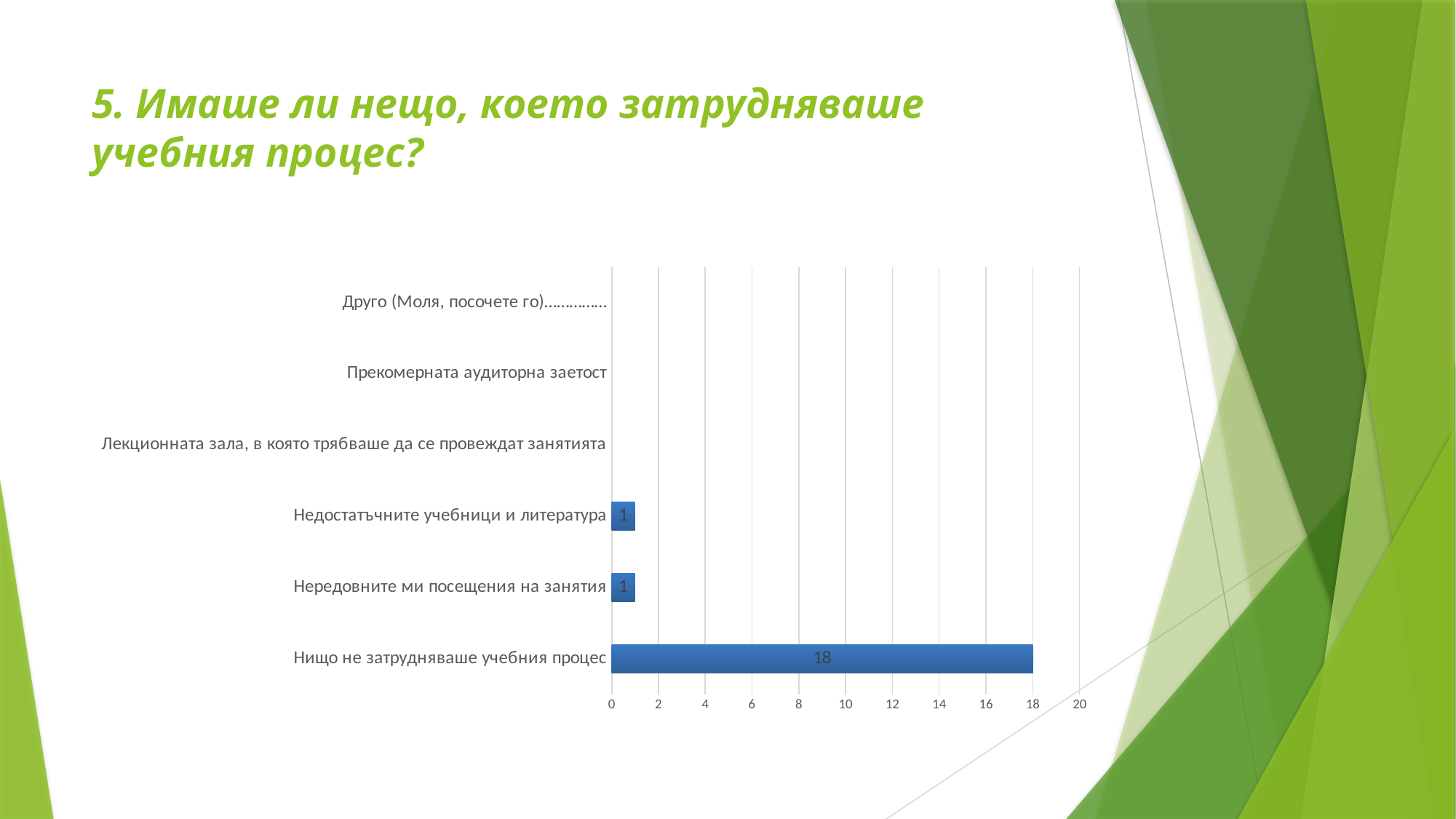
How many categories have no visible bar on the chart? 3 How many categories are listed on the chart? 6 Which category has the highest value? Нищо не затрудняваше учебния процес Which is larger: the value for "Нищо не затрудняваше учебния процес" or the value for "Недостатъчните учебници и литература"? Нищо не затрудняваше учебния процес What kind of chart is shown on the slide? bar chart What is the value for "Нищо не затрудняваше учебния процес"? 18 What is the title of the slide? 5. Имаше ли нещо, което затрудняваше учебния процес? Is the value for "Нищо не затрудняваше учебния процес" greater or less than 10? greater What is the value for "Нередовните ми посещения на занятия"? 1 Is the value for "Нередовните ми посещения на занятия" greater or less than 4? less What is the difference between the values for "Нищо не затрудняваше учебния процес" and "Нередовните ми посещения на занятия"? 17 What is the value for "Недостатъчните учебници и литература"? 1